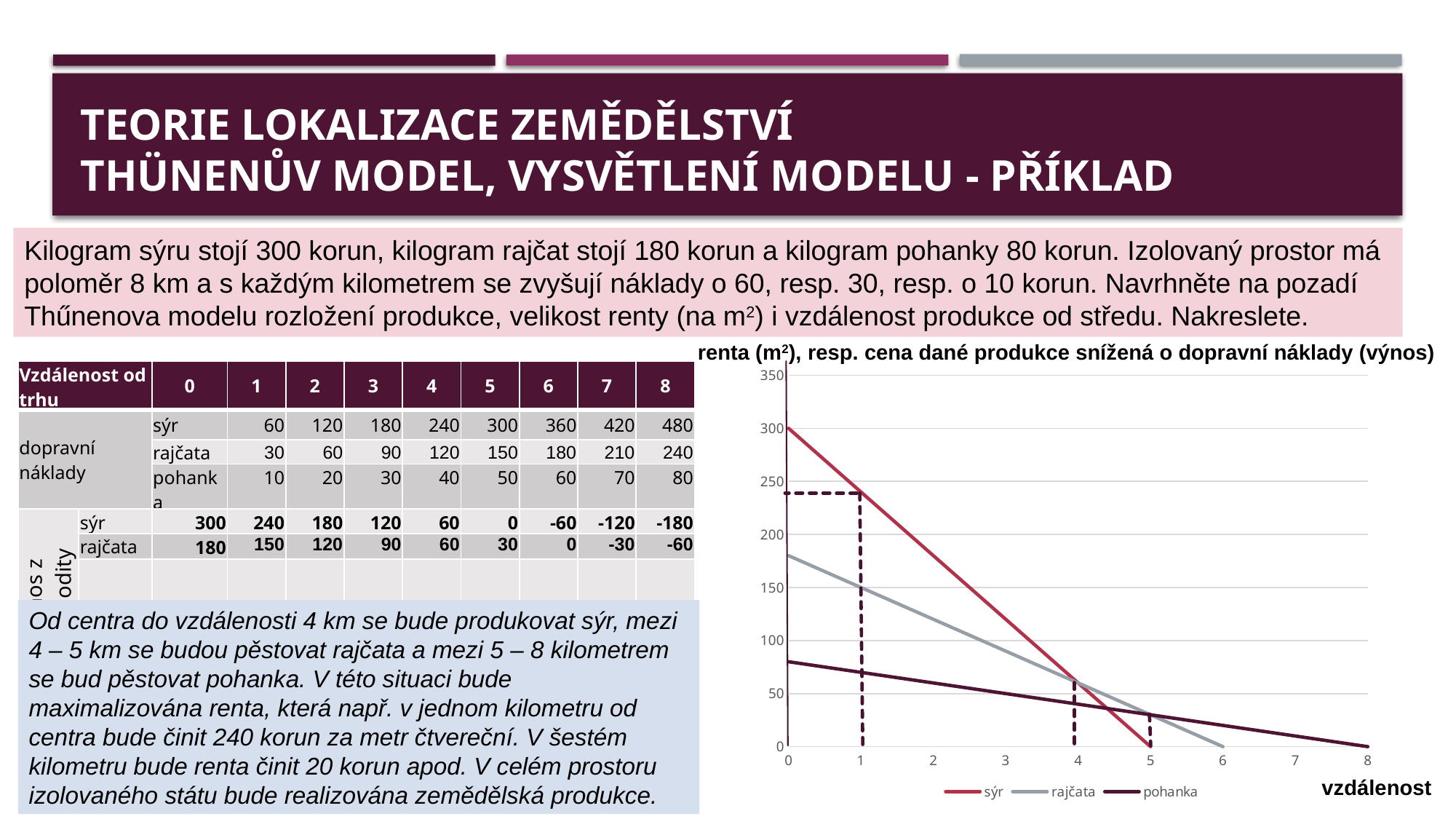
Is the value of the rajčata line at distance 0 greater or less than 150? greater Do the values of the sýr line rise or fall as distance increases? fall At what distance does the pohanka line reach 0? 8 At what distance does the sýr line reach 0? 5 Is the value of the pohanka line at distance 0 greater or less than 100? less Which series has the highest value at distance 0? sýr What kind of chart is shown on the right side of the slide? line chart Which series are listed in the chart legend? sýr, rajčata, pohanka Which series has the lowest value at distance 0? pohanka How many series does the chart legend list? 3 At what distance does the rajčata line reach 0? 6 What is the value of the sýr line at distance 0? 300